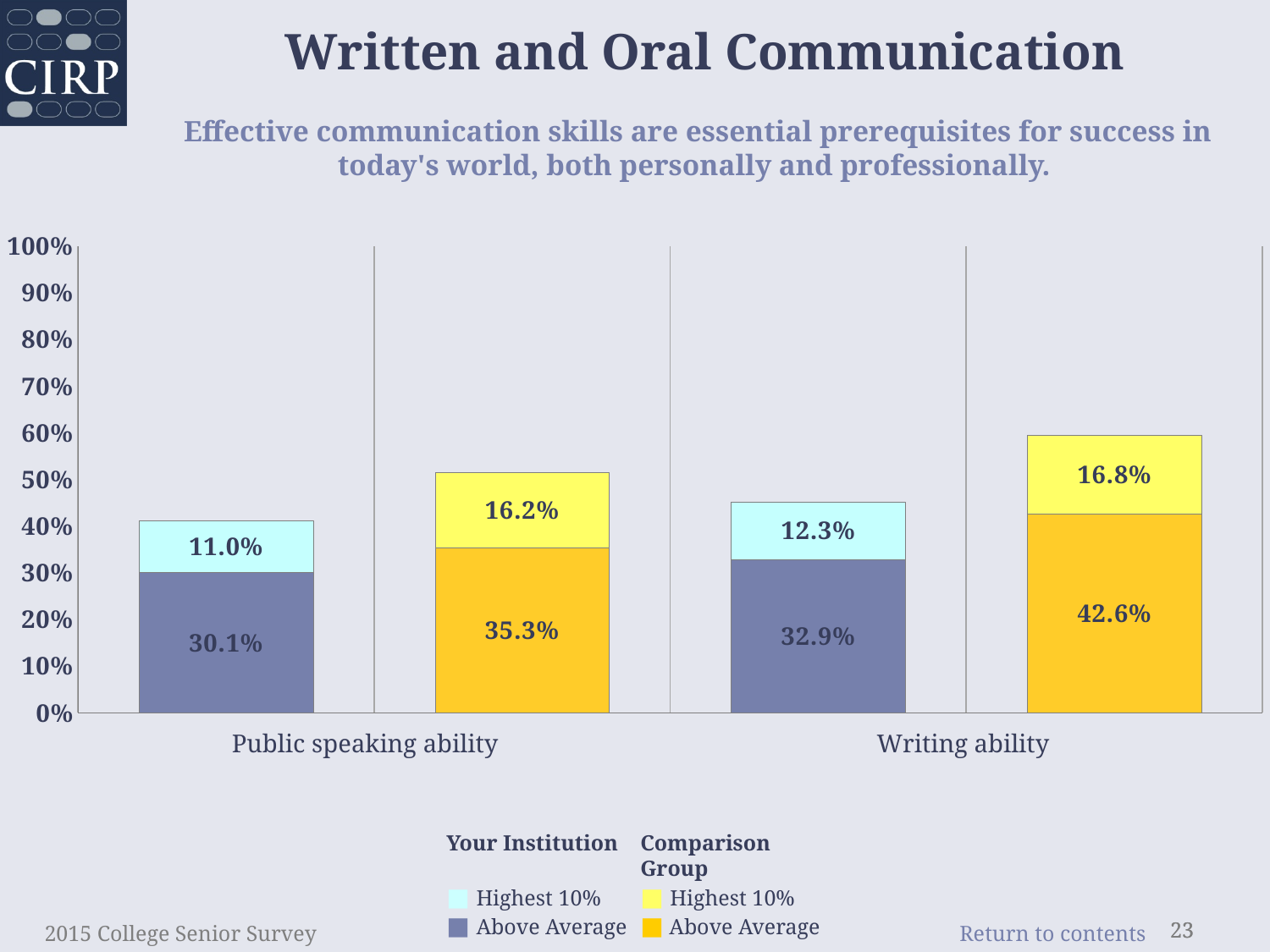
What kind of chart is shown on the slide? Stacked bar chart Which is larger for Public speaking ability: the Highest 10% value for Your Institution or for the Comparison Group? Comparison Group What is the Above Average value for Your Institution for Public speaking ability? 30.1% What is the total of the stacked bar for the Comparison Group for Writing ability? 59.4% Which Above Average value is the highest across all bars? 42.6% (Comparison Group, Writing ability) What is the difference between the Comparison Group's and Your Institution's Above Average values for Writing ability? 9.7% What is the Highest 10% value for Your Institution for Writing ability? 12.3% What is the Highest 10% value for the Comparison Group for Writing ability? 16.8% How many entries does the legend list? 4 What is the total of the stacked bar for Your Institution for Public speaking ability? 41.1% How many categories are shown on the x axis? 2 What is the Above Average value for the Comparison Group for Public speaking ability? 35.3%